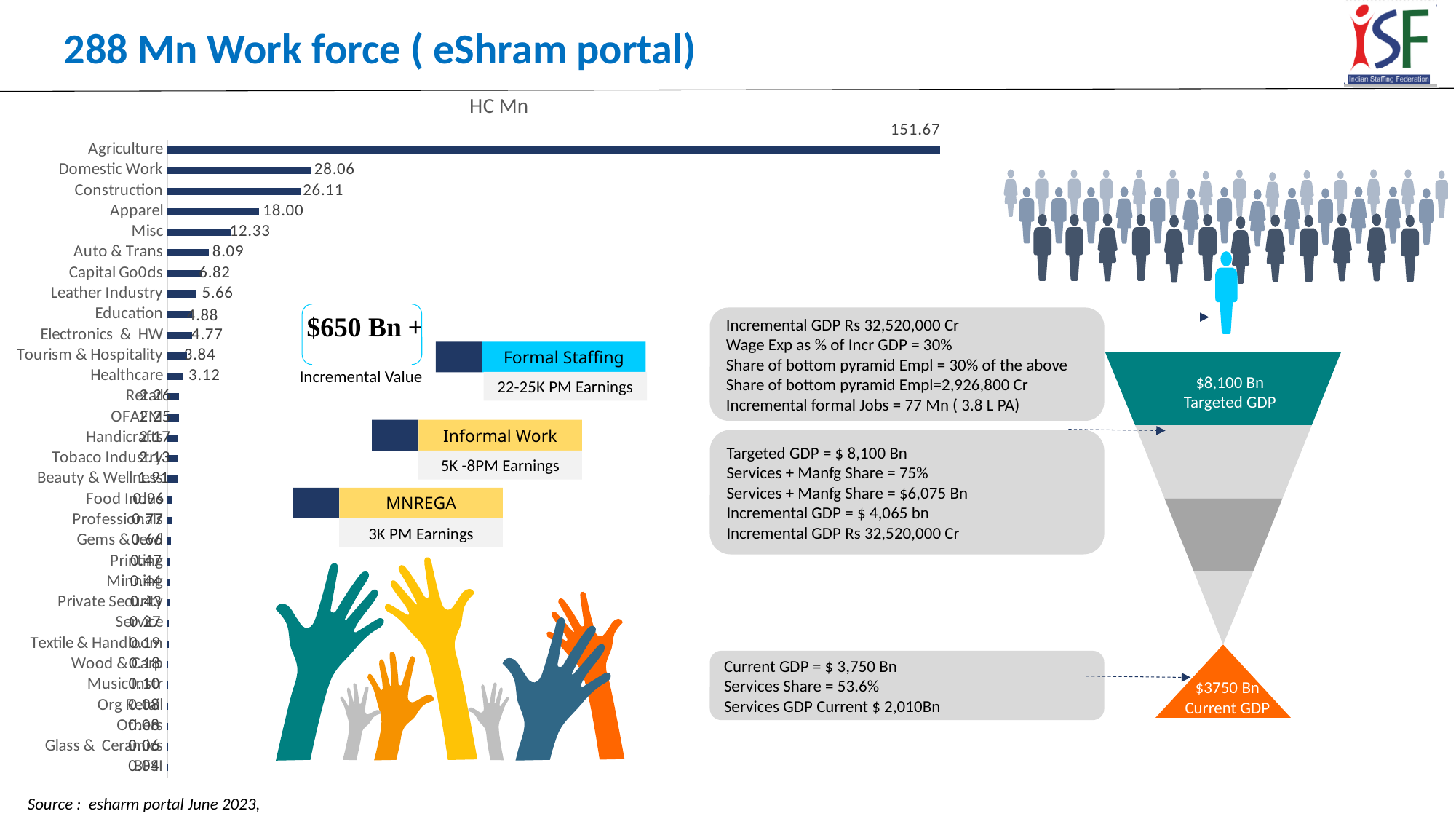
What is the value for Agriculture in the HC Mn chart? 151.67 In the HC Mn chart, which is larger: Auto & Trans or Leather Industry? Auto & Trans What kind of chart is the HC Mn chart? Bar chart What is the value for Apparel in the HC Mn chart? 18.00 In the HC Mn chart, which is larger: Apparel or Misc? Apparel What is the value for Domestic Work in the HC Mn chart? 28.06 What is the title of the bar chart on the slide? HC Mn What is the difference between Domestic Work and Construction in the HC Mn chart? 1.95 What is the difference between Agriculture and Domestic Work in the HC Mn chart? 123.61 What is the value for Construction in the HC Mn chart? 26.11 Which category has the highest value in the HC Mn chart? Agriculture What is the value for Healthcare in the HC Mn chart? 3.12